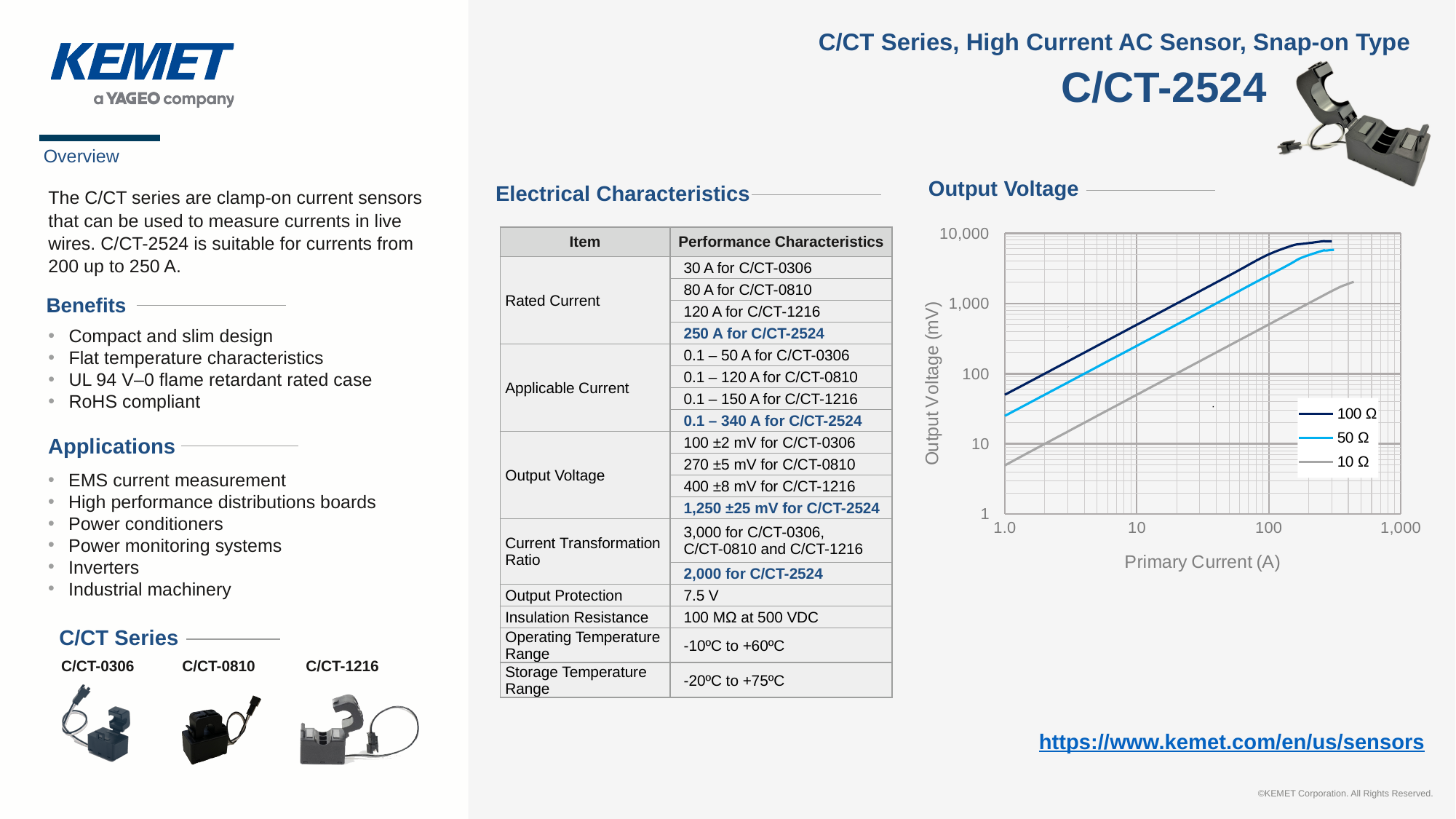
Which series in the Output Voltage chart has the lowest output voltage across the primary current range? 10 Ω In the Output Voltage chart, is the output voltage for the 10 Ω series at 100 A greater or less than 1,000 mV? less Which series in the Output Voltage chart has the highest output voltage across the primary current range? 100 Ω How many series does the legend of the Output Voltage chart list? 3 In the Output Voltage chart, is the output voltage for the 10 Ω series at 1.0 A greater or less than 10 mV? less In the Output Voltage chart, is the output voltage for the 100 Ω series at 100 A greater or less than 1,000 mV? greater In the Output Voltage chart, does the output voltage rise or fall as primary current increases? rise What is the label of the vertical axis of the Output Voltage chart? Output Voltage (mV) What kind of chart is the Output Voltage chart? line chart What is the label of the horizontal axis of the Output Voltage chart? Primary Current (A) In the Output Voltage chart, at a primary current of 10 A, which is larger: the output voltage for 100 Ω or for 10 Ω? 100 Ω